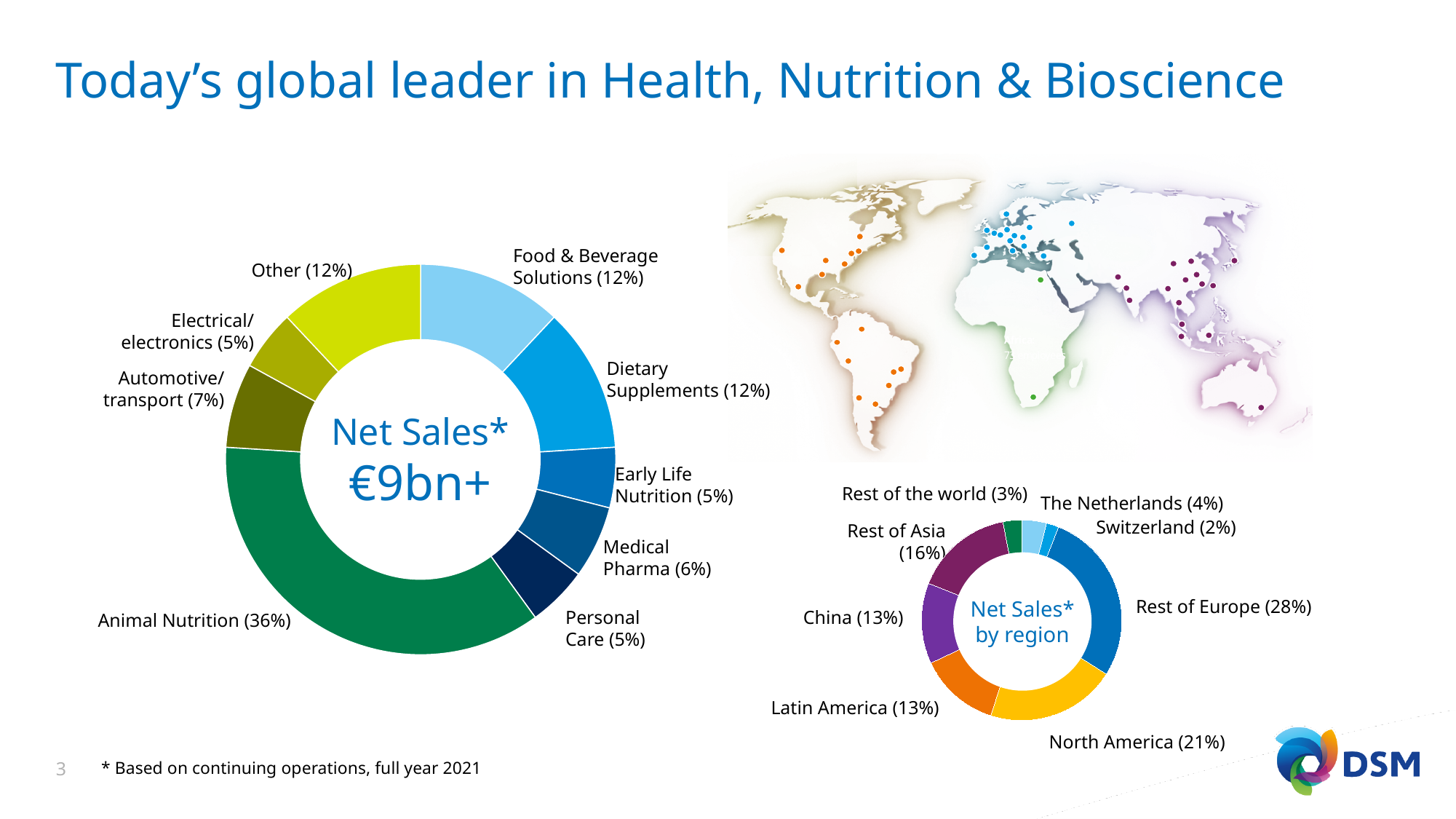
What type of chart is the 'Net Sales by region' chart on the right? Donut (pie) chart In the left 'Net Sales' donut chart, which is larger: Medical Pharma or Personal Care? Medical Pharma In the 'Net Sales by region' chart, which region has the smallest share? Switzerland In the left 'Net Sales' donut chart, what is the difference in share between Animal Nutrition and Automotive/transport? 29 percentage points In the left 'Net Sales' donut chart, what share does Animal Nutrition have? 36% In the left 'Net Sales' donut chart, what share does Medical Pharma have? 6% In the 'Net Sales by region' chart, what share does Rest of Europe have? 28% In the 'Net Sales by region' chart, what is the difference in share between North America and Latin America? 8 percentage points In the left 'Net Sales' donut chart, which segment has the largest share? Animal Nutrition In the 'Net Sales by region' chart, how many regions are shown? 8 What total net sales figure is shown in the centre of the left donut chart? €9bn+ In the left 'Net Sales' donut chart, how many segments are shown? 9